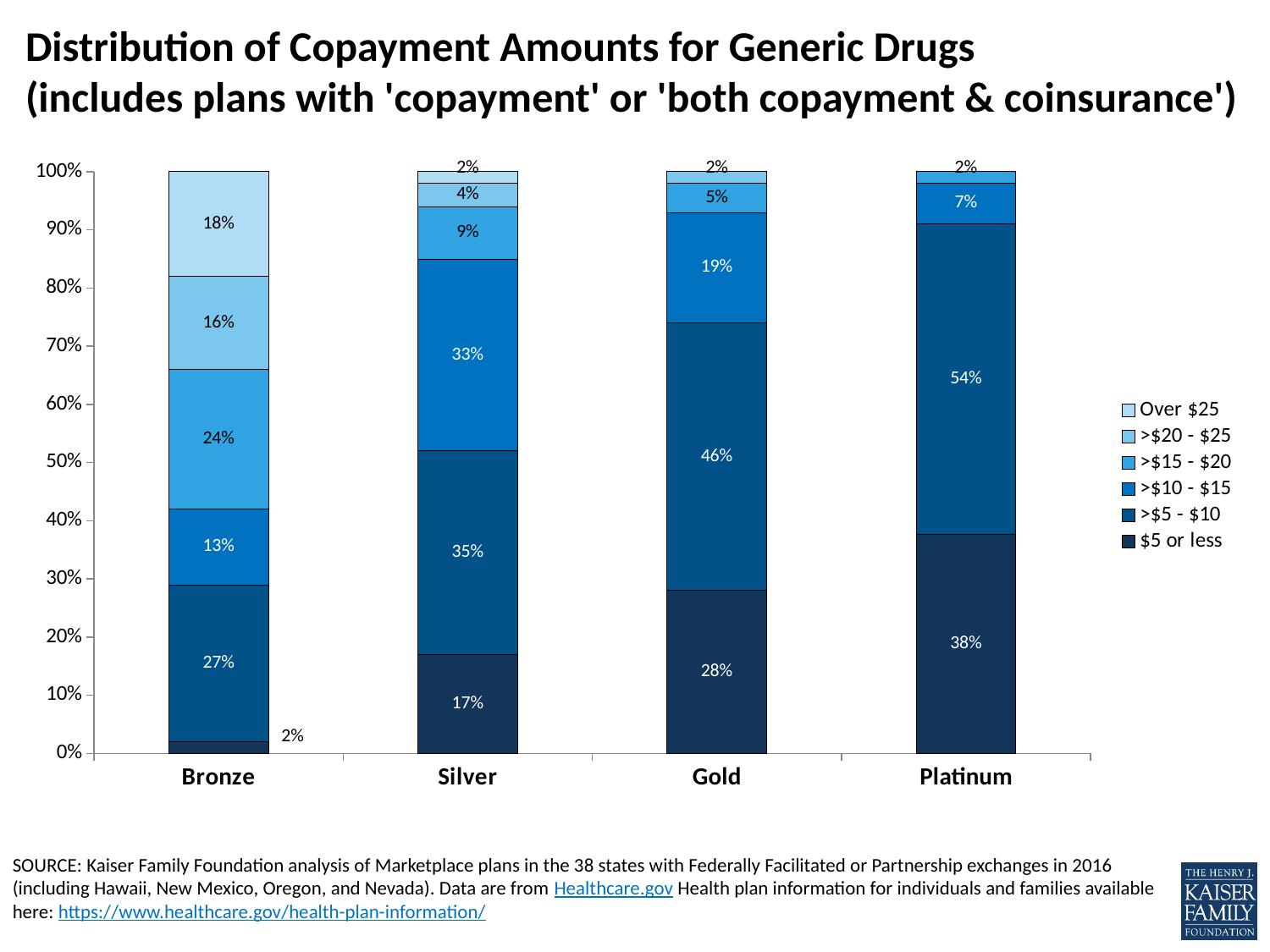
What is the difference between the >$5 - $10 share for Platinum and for Bronze? 27 percentage points What kind of chart is shown on the slide? stacked bar chart What share of Platinum plans have a generic drug copayment of $5 or less? 38% How many metal tiers (categories) are shown on the x axis? 4 How many series does the legend list? 6 Which is larger: the >$10 - $15 share for Silver or for Gold? Silver What share of Silver plans have a generic drug copayment of >$10 - $15? 33% Which metal tier has the smallest share of plans with a generic drug copayment of $5 or less? Bronze What share of Bronze plans have a generic drug copayment of Over $25? 18% What share of Bronze plans have a generic drug copayment of $5 or less? 2% Which metal tier has the largest share of plans with a generic drug copayment of $5 or less? Platinum What share of Gold plans have a generic drug copayment of >$5 - $10? 46%